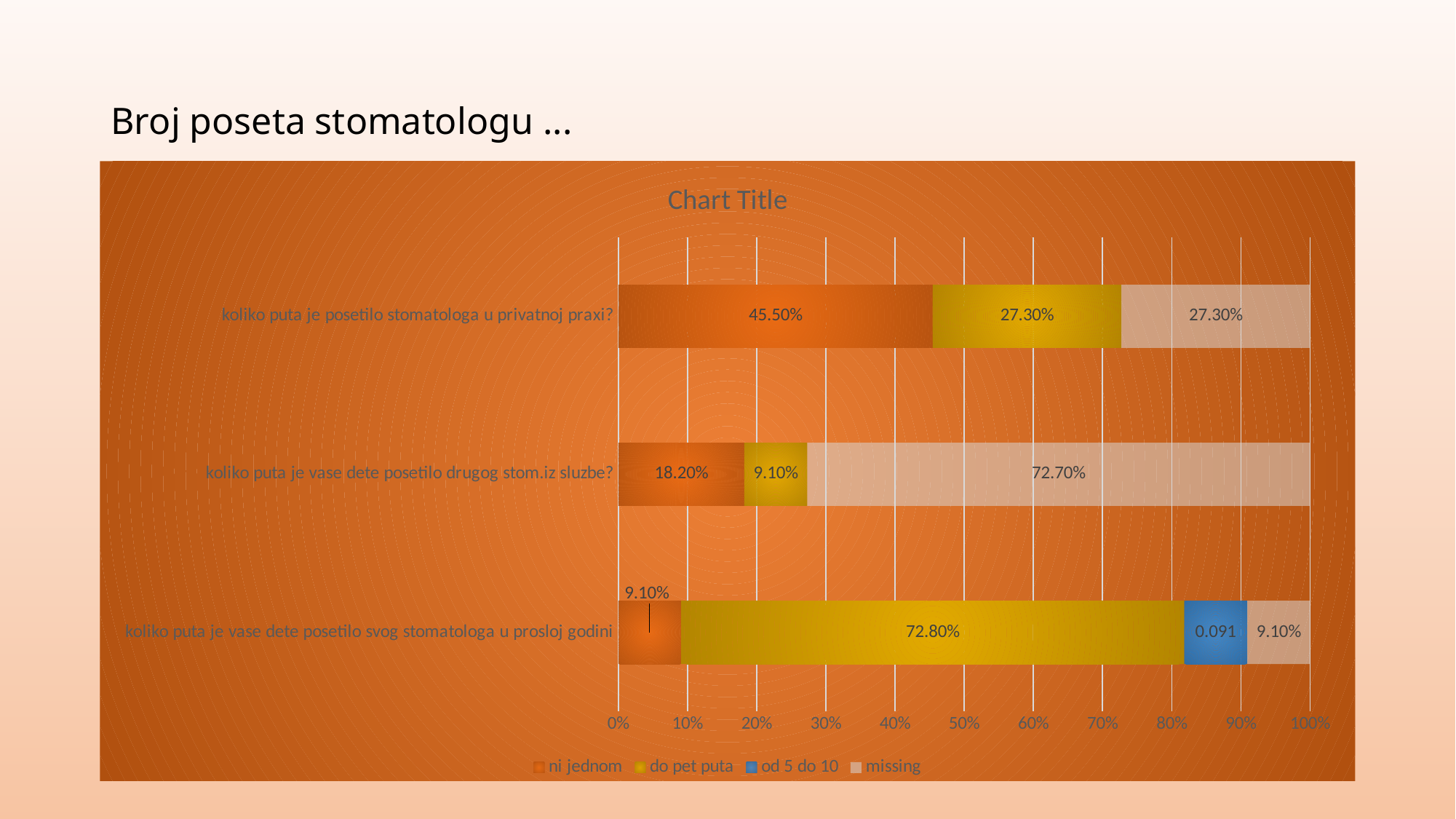
How many series does the legend list? 4 Which category has the highest 'ni jednom' value? koliko puta je posetilo stomatologa u privatnoj praxi? What is the value of 'ni jednom' for 'koliko puta je posetilo stomatologa u privatnoj praxi?'? 45.50% What is the title shown above the chart? Chart Title What is the value of 'do pet puta' for 'koliko puta je vase dete posetilo svog stomatologa u prosloj godini'? 72.80% Which is larger: 'do pet puta' for 'koliko puta je posetilo stomatologa u privatnoj praxi?' or 'do pet puta' for 'koliko puta je vase dete posetilo drugog stom.iz sluzbe?'? koliko puta je posetilo stomatologa u privatnoj praxi? What is the difference between the 'ni jednom' values for 'koliko puta je posetilo stomatologa u privatnoj praxi?' and 'koliko puta je vase dete posetilo drugog stom.iz sluzbe?'? 27.30% How many categories (questions) are plotted on the chart? 3 What is the value of 'missing' for 'koliko puta je vase dete posetilo drugog stom.iz sluzbe?'? 72.70% What is the data label shown for 'od 5 do 10' in the category 'koliko puta je vase dete posetilo svog stomatologa u prosloj godini'? 0.091 Which category has the lowest 'missing' value? koliko puta je vase dete posetilo svog stomatologa u prosloj godini What type of chart is shown on the slide? stacked bar chart